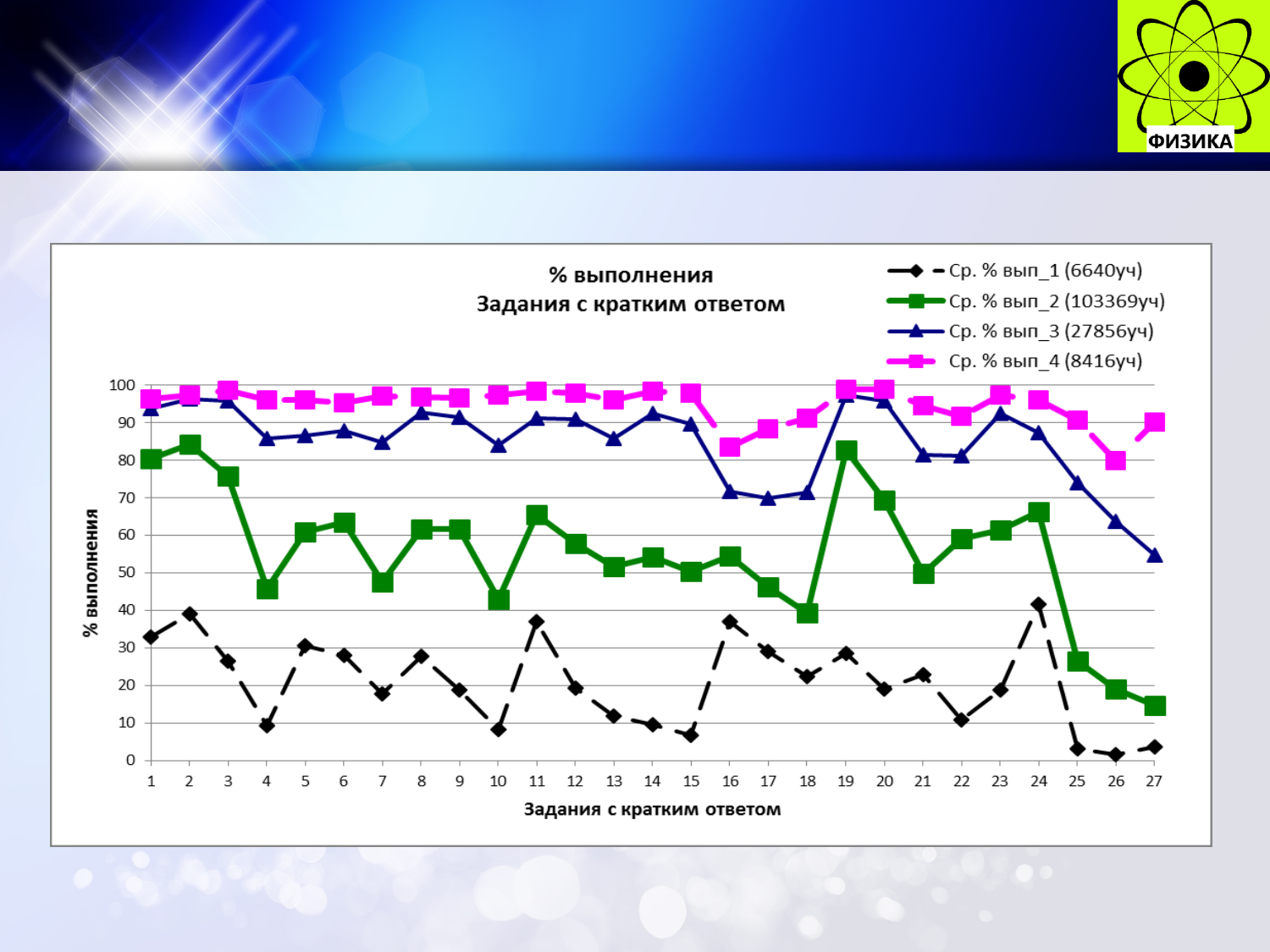
What is the title of the chart? % выполнения Задания с кратким ответом What kind of chart is shown on the slide? line chart Is the value of Ср. % вып_2 for task 4 greater or less than 50? less What is the legend entry for the green series with square markers? Ср. % вып_2 (103369уч) Is the value of Ср. % вып_3 for task 17 greater or less than 80? less How many tasks (x-axis categories) are plotted on the chart? 27 Does the value of Ср. % вып_2 rise or fall from task 24 to task 27? fall Is the value of Ср. % вып_1 for task 25 greater or less than 10? less For Ср. % вып_2, which task has the larger value: task 19 or task 20? task 19 For which task is the value of Ср. % вып_2 the lowest? 27 How many series does the legend list? 4